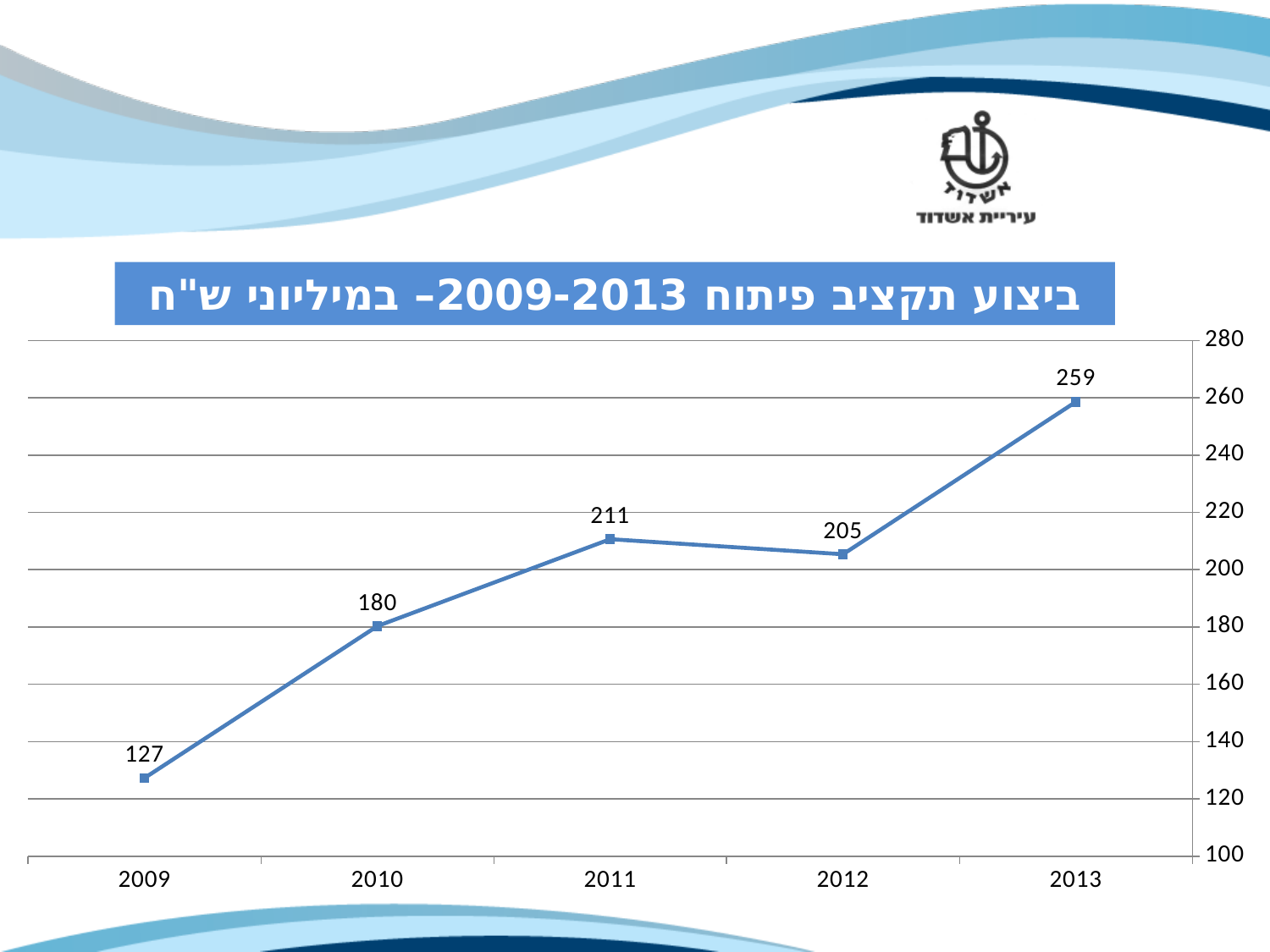
Which is larger, the value for 2010 or the value for 2012? 2012 What is the difference between the values for 2011 and 2012? 6 What is the difference between the values for 2013 and 2009? 132 Which year has the lowest value? 2009 Is the value for 2010 greater or less than 160? greater What is the value for 2013? 259 How many years are plotted on the chart? 5 What kind of chart is shown on the slide? line chart Which year has the highest value? 2013 Does the value rise or fall from 2011 to 2012? fall What is the value for 2009? 127 What is the value for 2011? 211